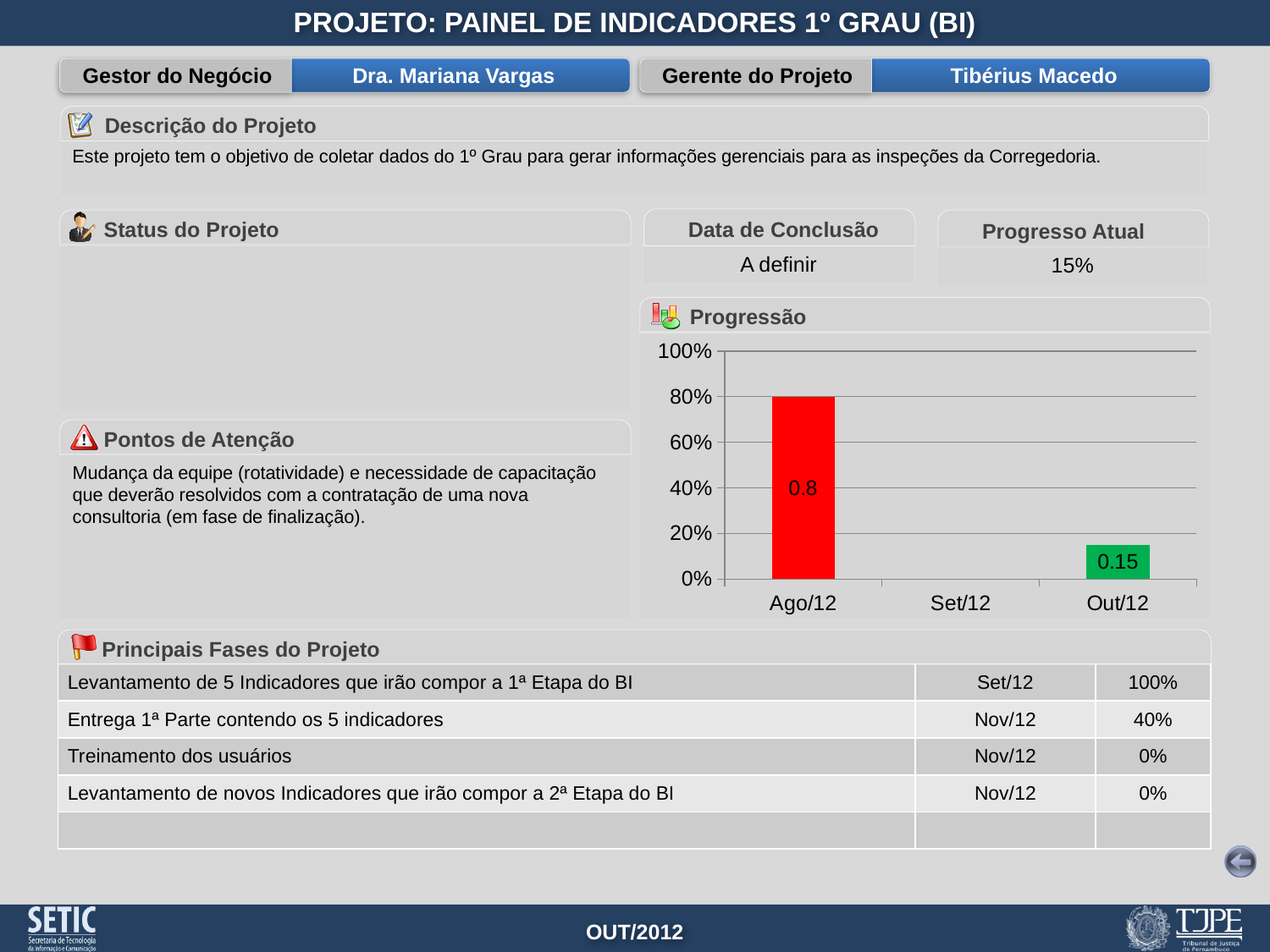
In the Progressão chart, do the bar values rise or fall from Ago/12 to Out/12? fall In the Progressão chart, what is the difference between the values for Ago/12 and Out/12? 0.65 In the Progressão chart, is the value for Out/12 greater or less than 20%? less In the Progressão chart, what is the value shown for Out/12? 0.15 In the Progressão chart, which is larger, the value for Ago/12 or the value for Out/12? Ago/12 In the Progressão chart, which month has the highest bar? Ago/12 In the Progressão chart, what colour is the bar for Ago/12? red What kind of chart is the Progressão chart? bar chart How many categories are shown on the x axis of the Progressão chart? 3 In the Progressão chart, is the value for Ago/12 greater or less than 60%? greater What is the title of the chart on the slide? Progressão In the Progressão chart, what is the value shown for Ago/12? 0.8